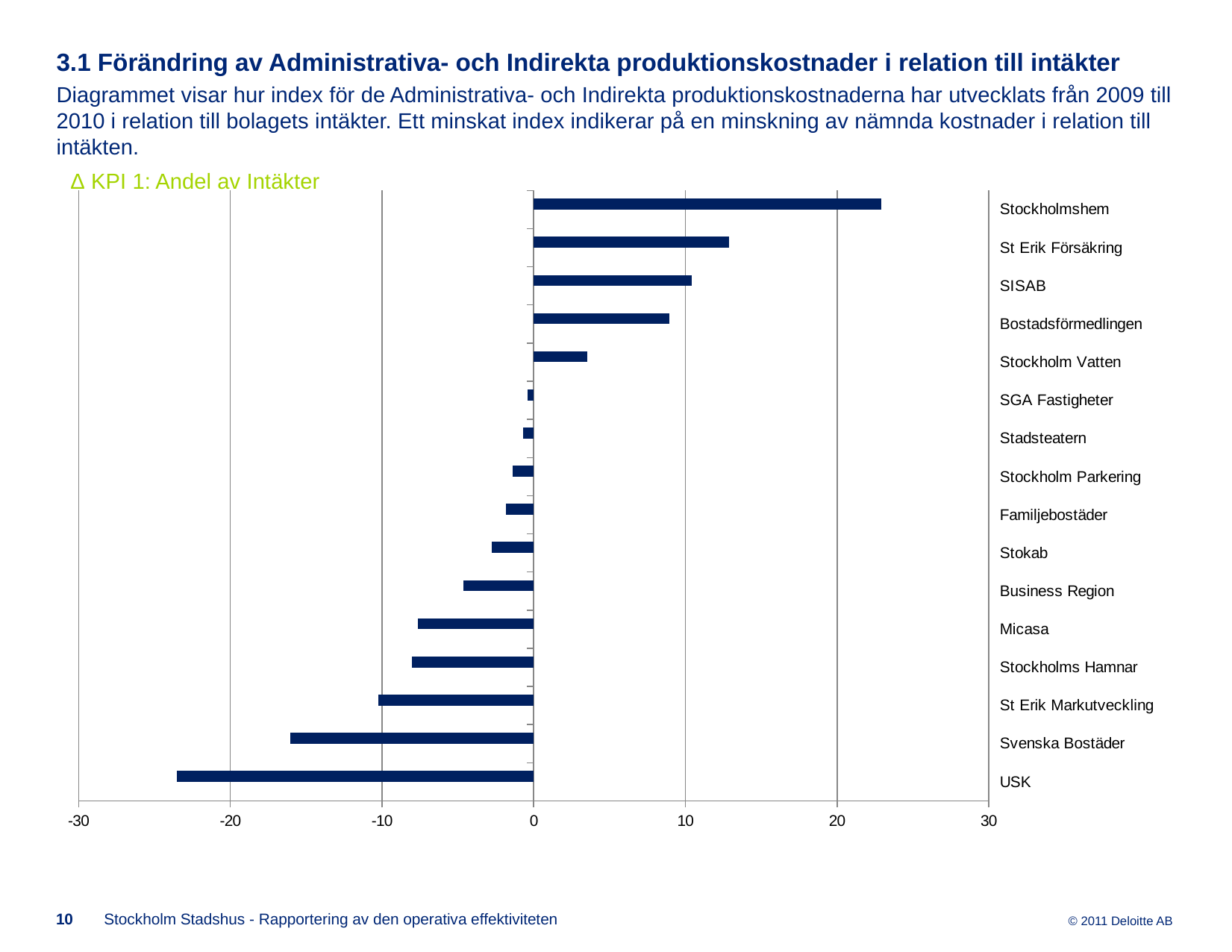
Is the value for Stockholmshem greater or less than 20? greater Which company has the highest value in the chart? Stockholmshem Which company has the lowest value in the chart? USK Is the value for St Erik Försäkring greater or less than 10? greater How many companies are listed in the chart? 16 Which has the larger value, Stockholmshem or St Erik Försäkring? Stockholmshem What is the title of the chart? Δ KPI 1: Andel av Intäkter Is the value for USK greater or less than -20? less Which has the lower value, Svenska Bostäder or USK? USK What kind of chart is shown on the slide? bar chart